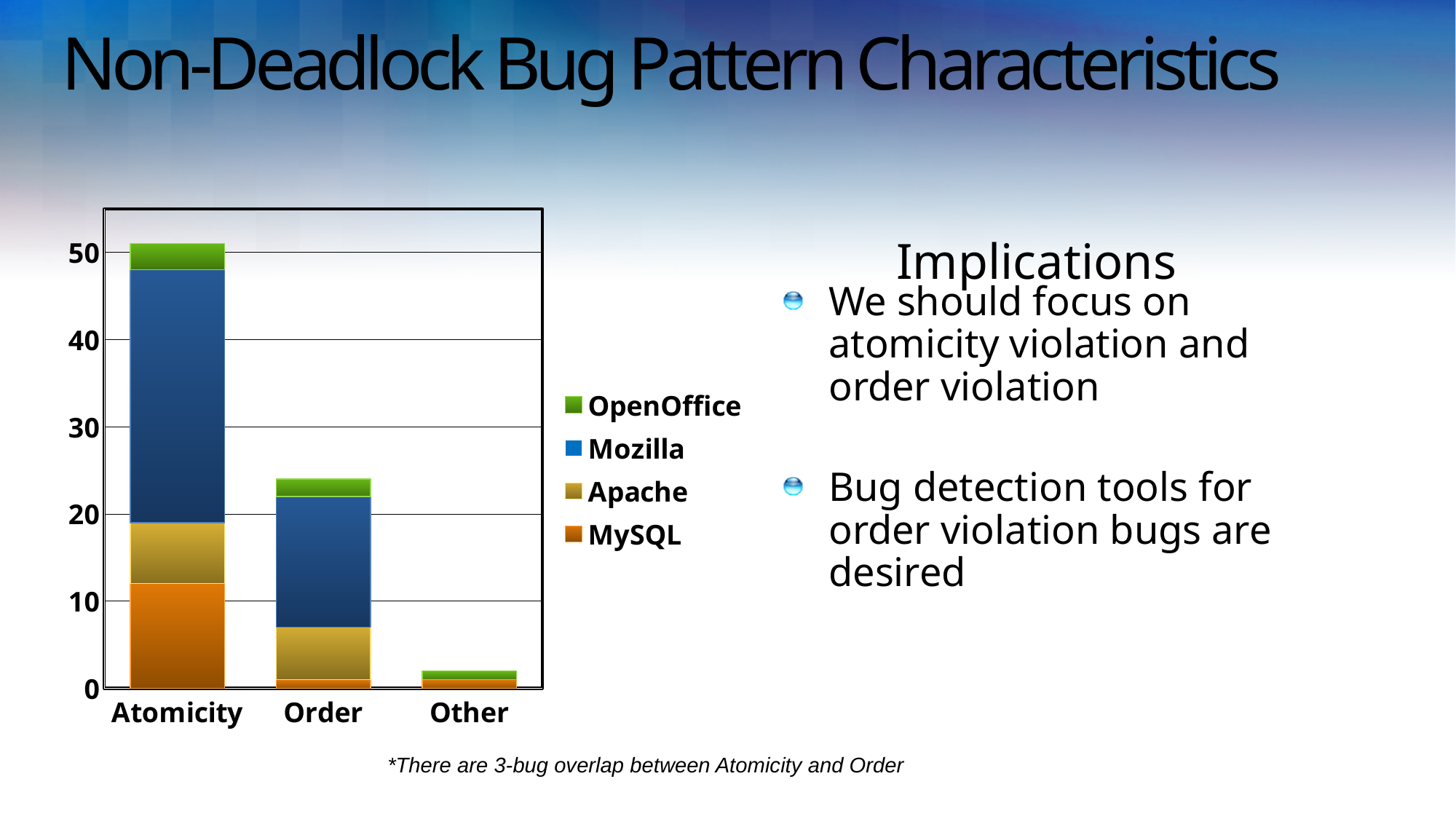
Is the total for Other greater or less than 10? less Which series is shown in green in the chart's legend? OpenOffice Is the total for Order greater or less than 30? less How many categories are shown on the x axis of the chart? 3 Which series is listed last in the chart's legend? MySQL How many series does the chart's legend list? 4 Is the total for Order greater or less than 20? greater What kind of chart is shown on the slide? stacked bar chart Which category has the shortest stacked bar? Other Which stacked bar is taller, Order or Other? Order Which category has the tallest stacked bar? Atomicity